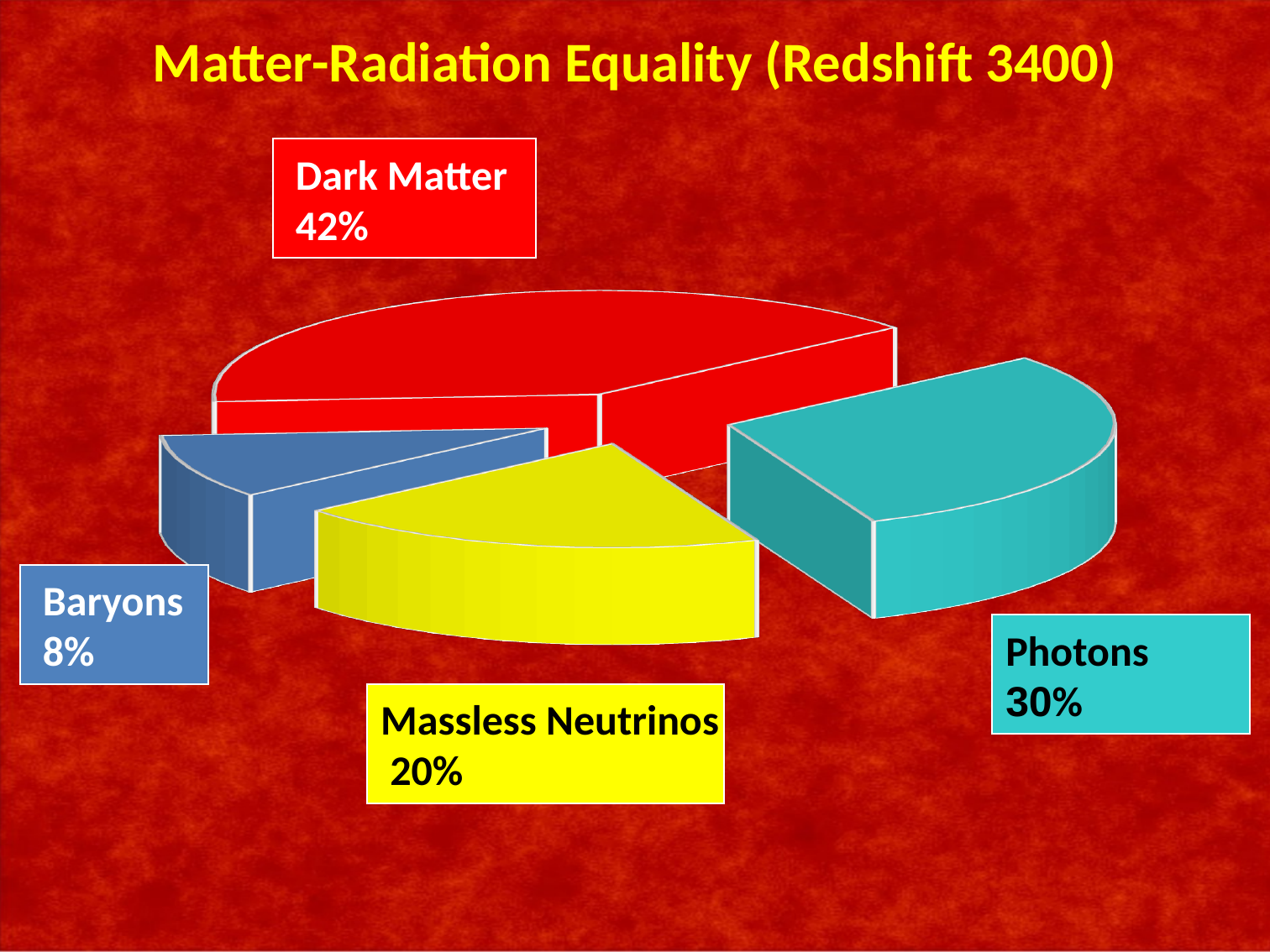
What share of the pie do Massless Neutrinos have? 20% Which category has the largest slice of the pie? Dark Matter What share of the pie does Dark Matter have? 42% Which category has the smallest slice of the pie? Baryons What kind of chart is shown on the slide? Pie chart What is the difference in percentage points between Massless Neutrinos and Baryons? 12 What is the difference in percentage points between Dark Matter and Photons? 12 Which is larger, the share for Photons or the share for Massless Neutrinos? Photons What share of the pie do Photons have? 30% What is the title of the chart? Matter-Radiation Equality (Redshift 3400) How many slices does the pie chart have? 4 What share of the pie do Baryons have? 8%